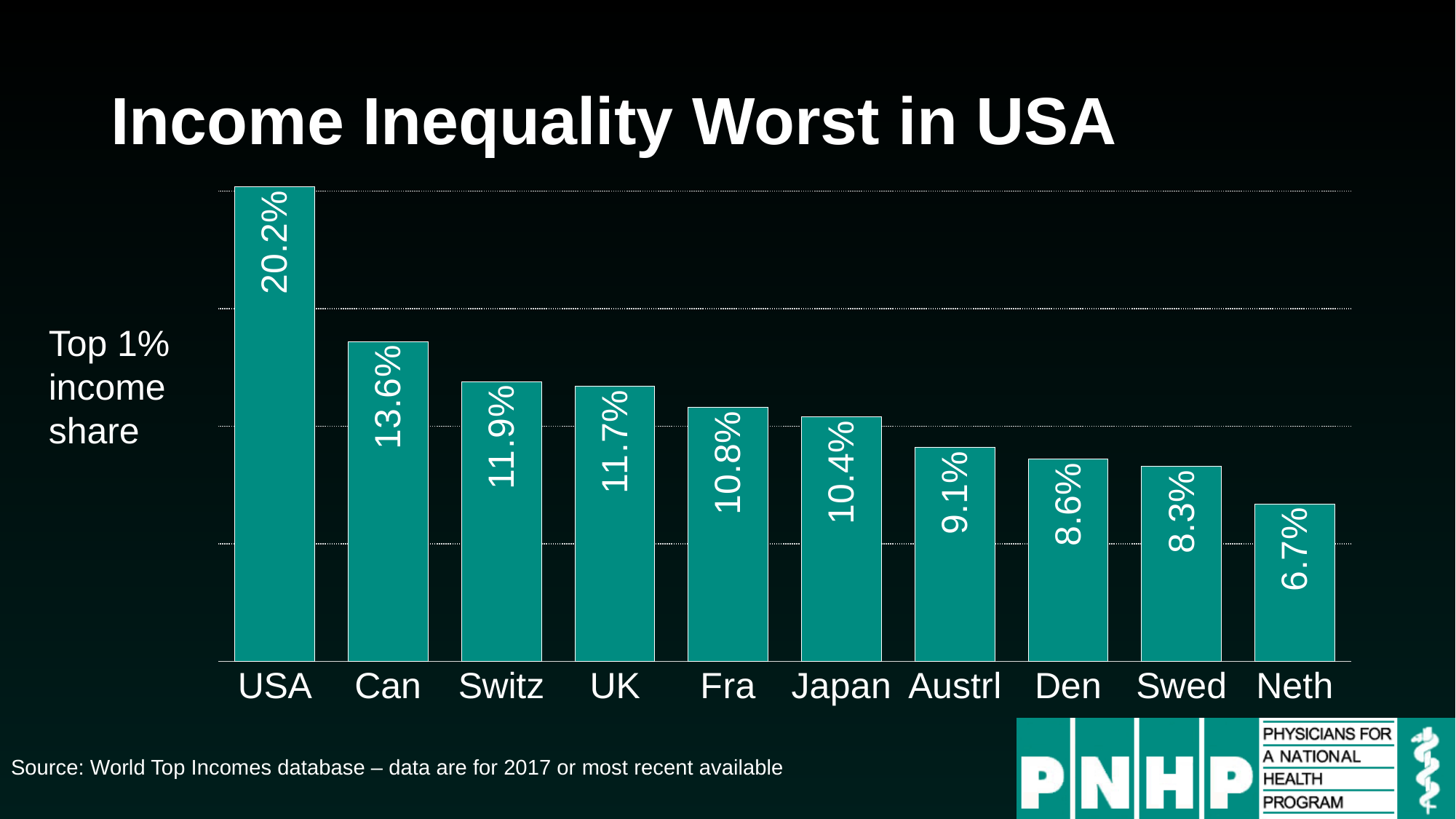
Do the values rise or fall from left to right across the countries? Fall Which has a larger top 1% income share, France or Australia? Fra How many countries are shown in the chart? 10 What is the top 1% income share for the USA? 20.2% What is the difference between the top 1% income share of the UK and the Netherlands? 5.0% What is the top 1% income share for Sweden (Swed)? 8.3% Which has a larger top 1% income share, Denmark or Switzerland? Switz What is the difference between the top 1% income share of the USA and Canada? 6.6% Which country has the highest top 1% income share? USA What kind of chart is shown on the slide? Bar chart Which country has the lowest top 1% income share? Neth What is the top 1% income share for Japan? 10.4%